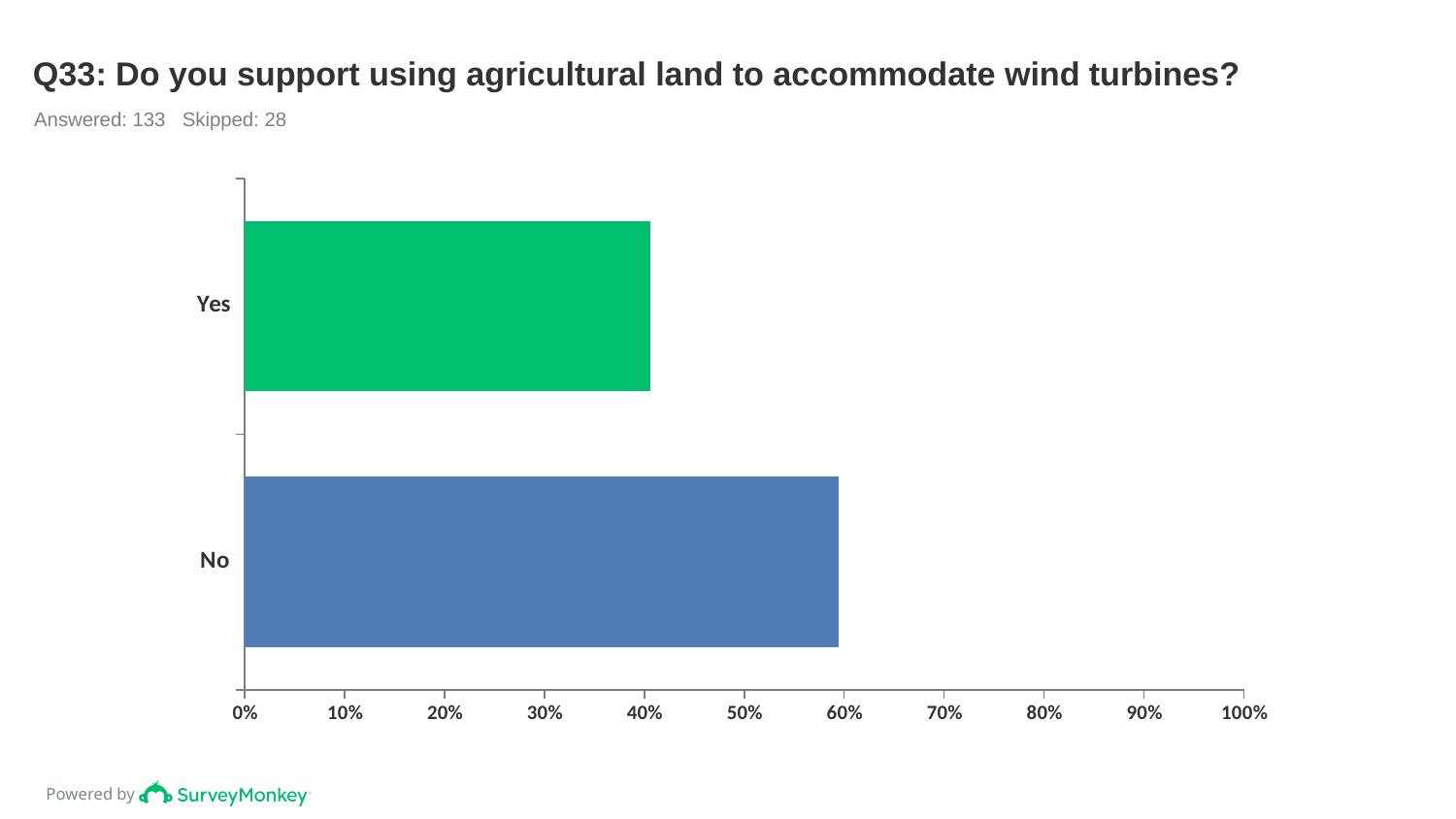
Which category has the lowest value? Yes What is the title of the chart? Q33: Do you support using agricultural land to accommodate wind turbines? Which is larger, the value for Yes or the value for No? No Is the value for Yes greater or less than 30%? greater Is the value for No greater or less than 50%? greater How many respondents answered the question according to the slide? 133 What kind of chart is shown on the slide? bar chart Is the value for Yes greater or less than 50%? less How many categories are plotted in the chart? 2 Which category has the highest value? No